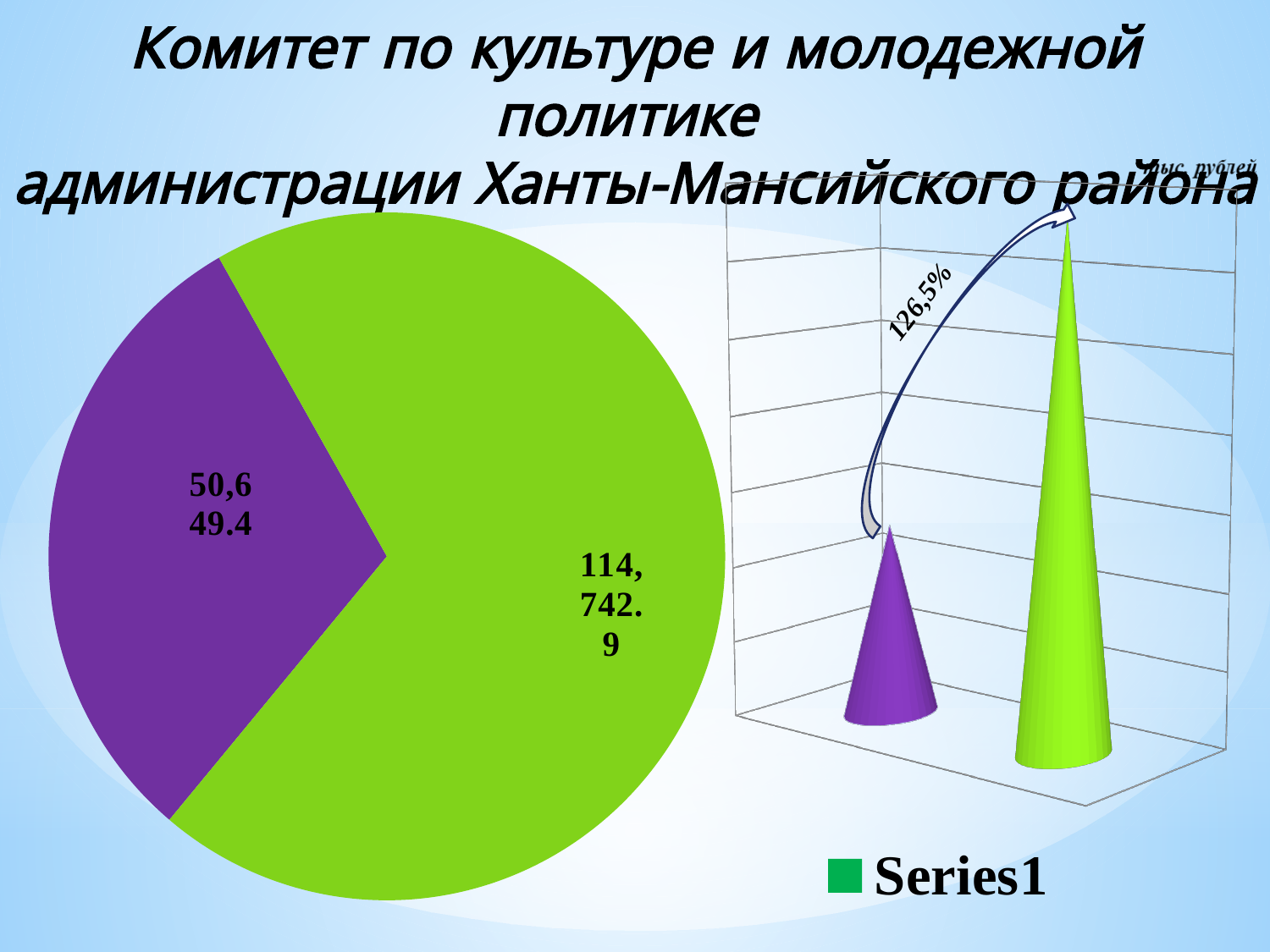
What kind of chart is on the right side of the slide? bar chart What percentage is written next to the arrow in the chart on the right? 126,5% In the pie chart on the left, what value is printed on the purple slice? 50,649.4 How many slices does the pie chart on the left have? 2 In the pie chart on the left, which slice is the largest? the green slice In the pie chart on the left, what is the difference between the green slice's value and the purple slice's value? 64,093.5 In the pie chart on the left, is the green slice's value larger or smaller than the purple slice's value? larger How many bars (cones) does the chart on the right show? 2 What kind of chart is on the left side of the slide? pie chart In the pie chart on the left, which slice is the smallest? the purple slice In the pie chart on the left, what value is printed on the green slice? 114,742.9 In the chart on the right, which cone is taller, the purple one or the green one? the green one